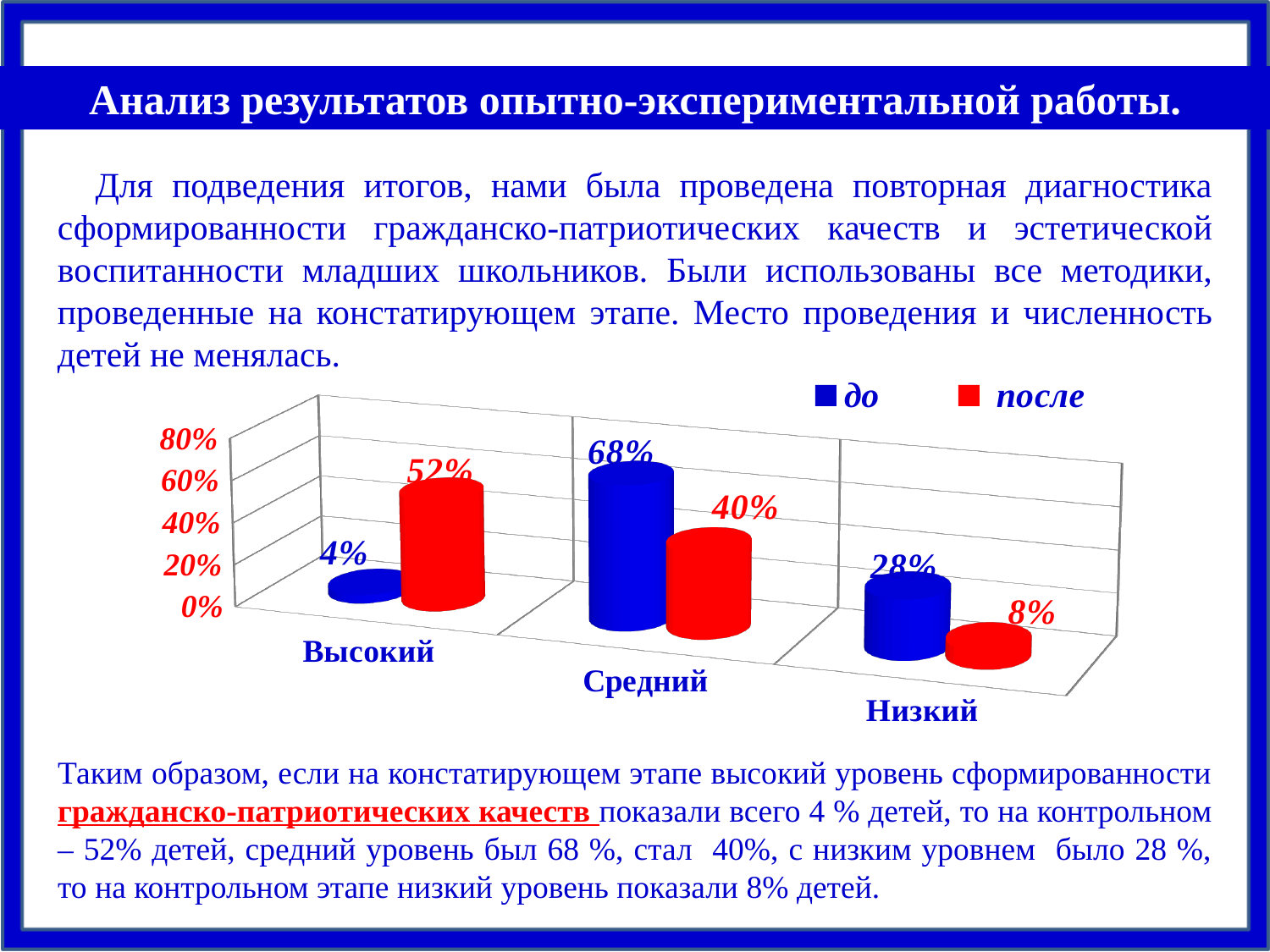
What is the difference between the "до" and "после" values in the "Средний" category? 28% What kind of chart is shown on the slide? Bar chart How many categories are shown on the x axis of the chart? 3 What is the value for "до" in the "Средний" category? 68% What is the value for "после" in the "Высокий" category? 52% What is the difference between the "после" and "до" values in the "Высокий" category? 48% What is the value for "до" in the "Высокий" category? 4% What is the value for "после" in the "Низкий" category? 8% Which category has the lowest value for the "после" series? Низкий How many series does the chart legend list? 2 In the "Низкий" category, which is larger: the "до" value or the "после" value? до Which category has the highest value for the "до" series? Средний